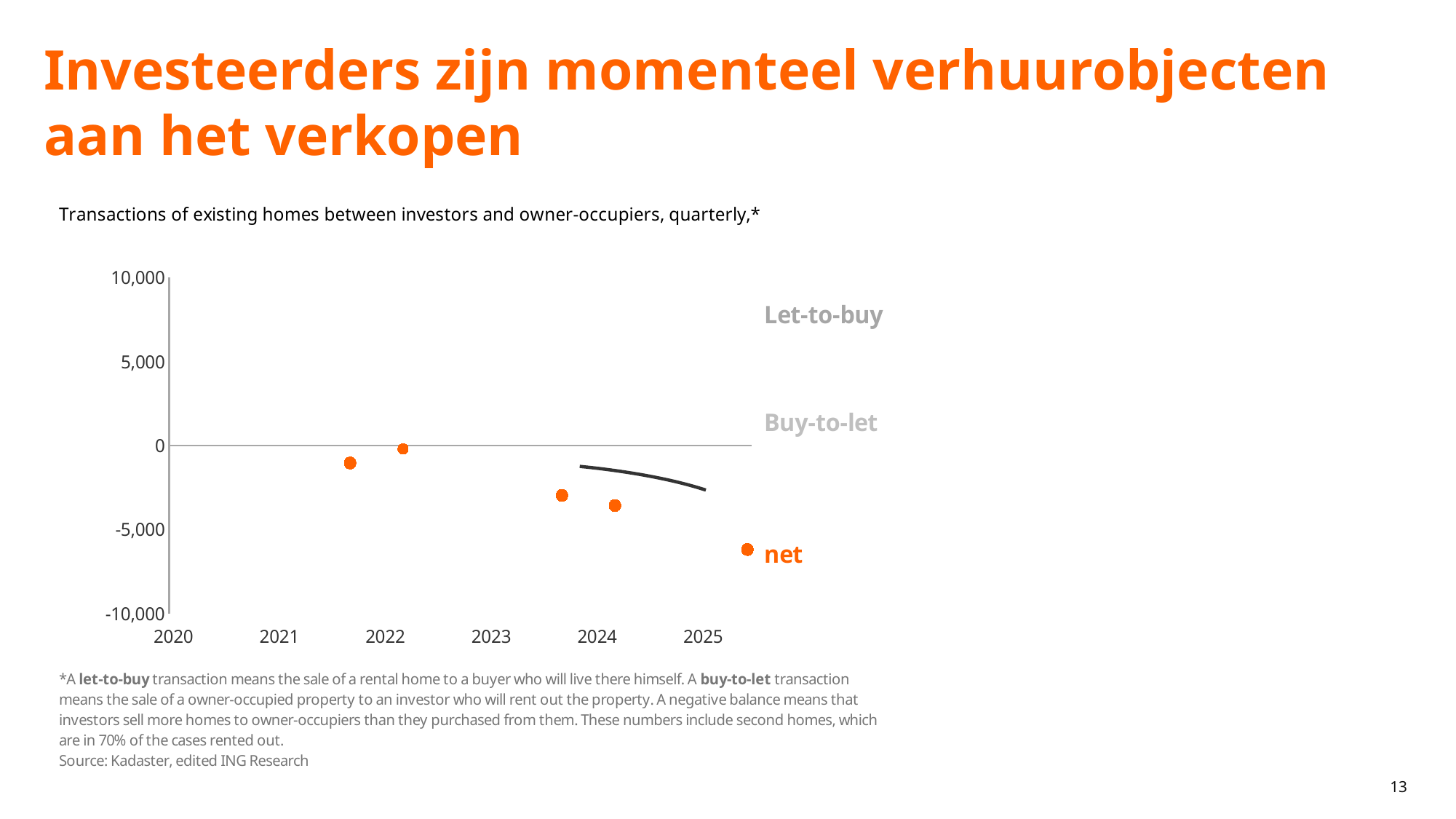
Is the net value for the point near 2022 greater or less than 0? less Do the net values rise or fall from 2022 to 2025? fall Is the net value for the point in 2025 greater or less than -10,000? greater What label is attached to the orange dots in the chart? net What is the title of the chart? Transactions of existing homes between investors and owner-occupiers, quarterly,* Which is larger, the net value near 2022 or the net value in 2025? 2022 Is the net value for the latest point, in 2025, greater or less than -5,000? less What is the lowest value shown on the y axis? -10,000 How many orange net points are plotted on the chart? 5 What is the highest value shown on the y axis? 10,000 Which year has the lowest net value plotted, 2022 or 2025? 2025